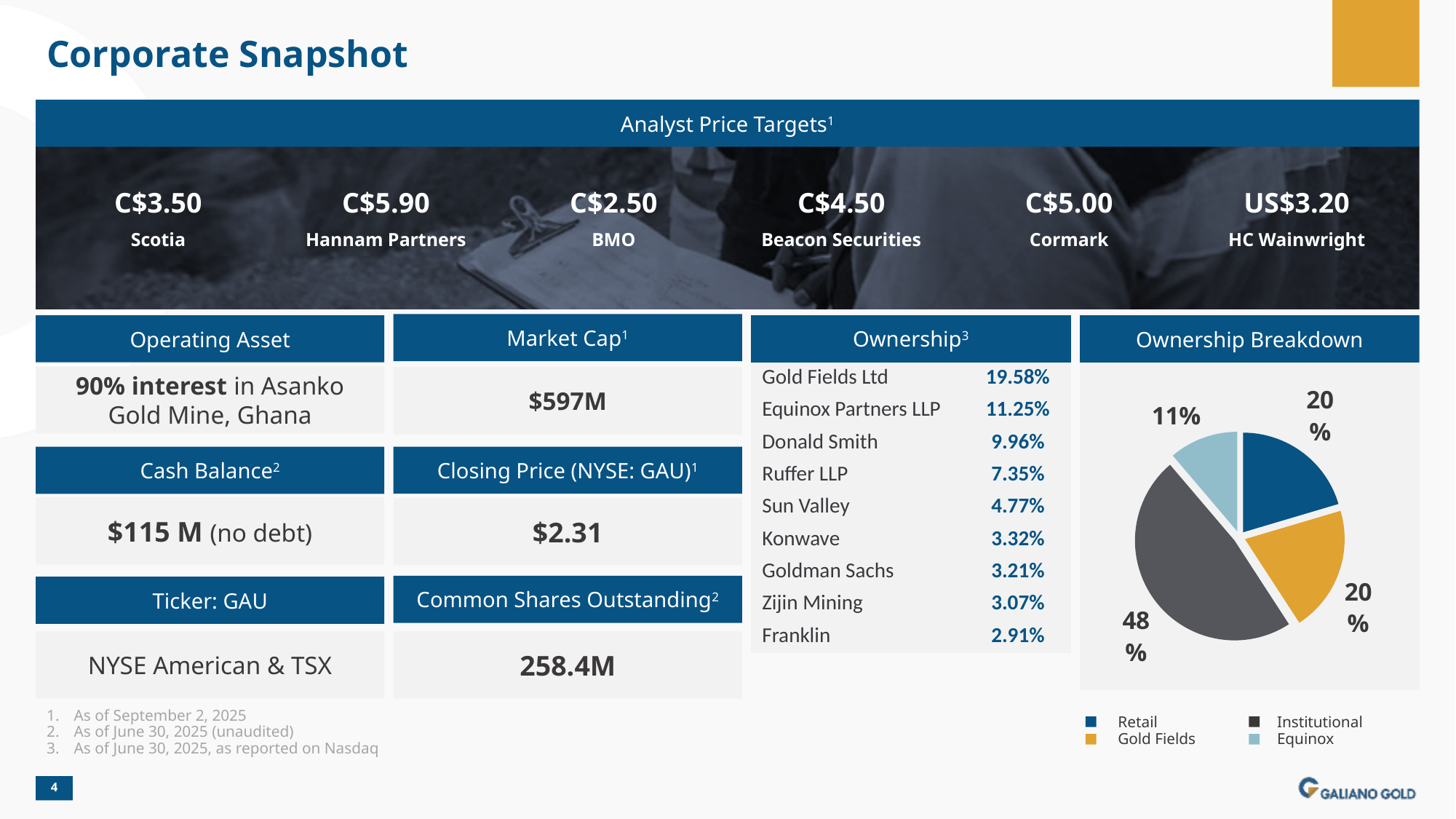
In the Ownership Breakdown pie chart, what share is labelled for Gold Fields? 20% In the Ownership Breakdown pie chart, how many slices are there? 4 In the Ownership Breakdown pie chart, which category has the largest slice? Institutional In the Ownership Breakdown pie chart, which category has the smallest slice? Equinox How many entries does the legend of the Ownership Breakdown pie chart list? 4 What kind of chart is the Ownership Breakdown chart? pie chart In the Ownership Breakdown pie chart, which is larger, the Institutional slice or the Retail slice? Institutional In the Ownership Breakdown pie chart, what share is labelled for Retail? 20% In the Ownership Breakdown pie chart, what share is labelled for Institutional? 48% In the Ownership Breakdown pie chart, what share is labelled for Equinox? 11% In the Ownership Breakdown pie chart, what is the difference between the Institutional share and the Equinox share? 37% In the Ownership Breakdown pie chart, what colour is the Institutional slice? dark grey